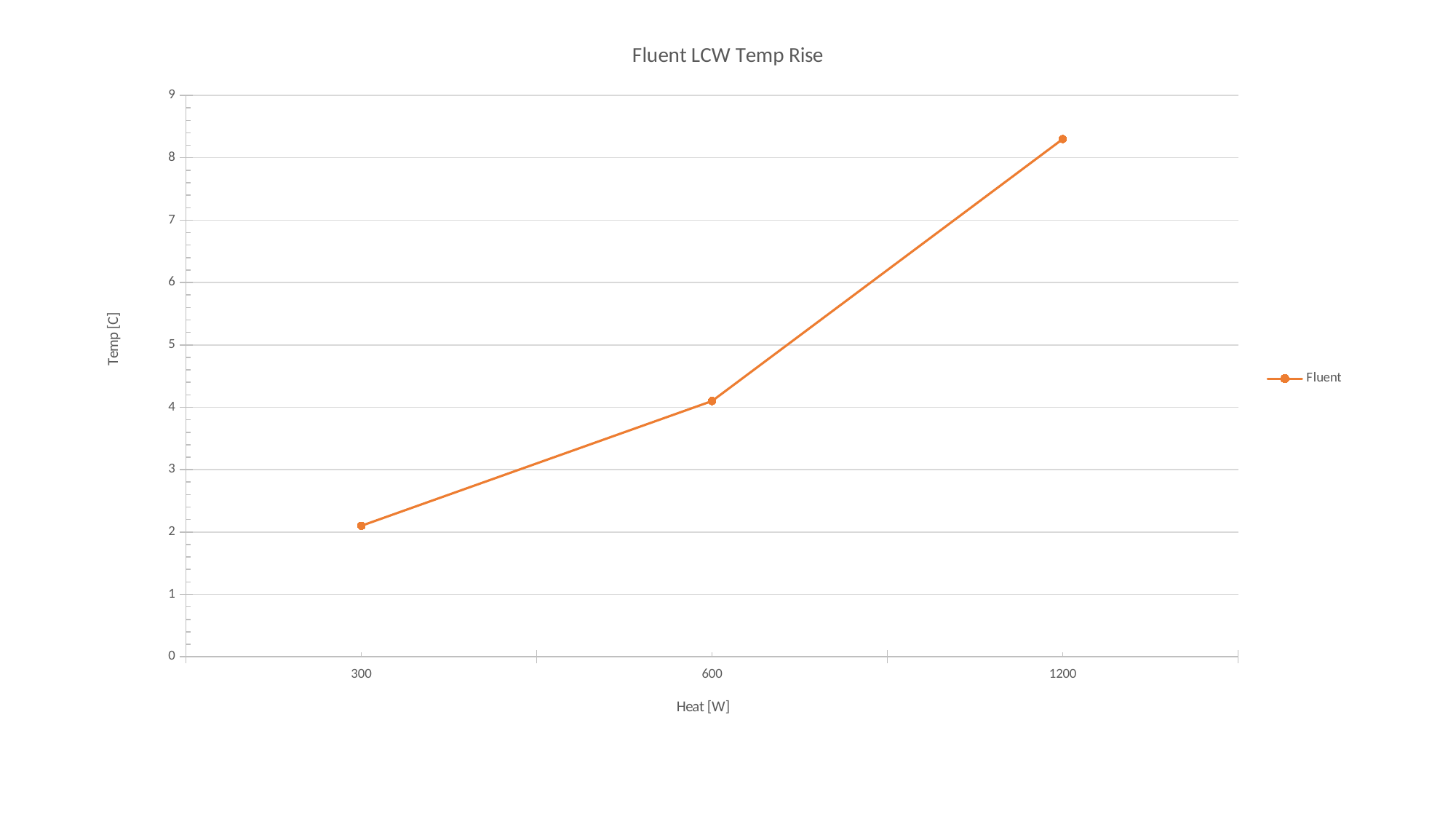
What kind of chart is shown on the slide? line chart Is the value for 300 W greater or less than 3? less How many data points are plotted on the line? 3 Which heat value has the lowest temperature rise? 300 Which has a larger temperature rise, 600 W or 1200 W? 1200 W Which heat value has the highest temperature rise? 1200 Do the values rise or fall as heat increases along the x axis? rise What is the title of the chart? Fluent LCW Temp Rise Is the value for 1200 W greater or less than 8? greater What is the label of the y axis? Temp [C] How many series does the legend list? 1